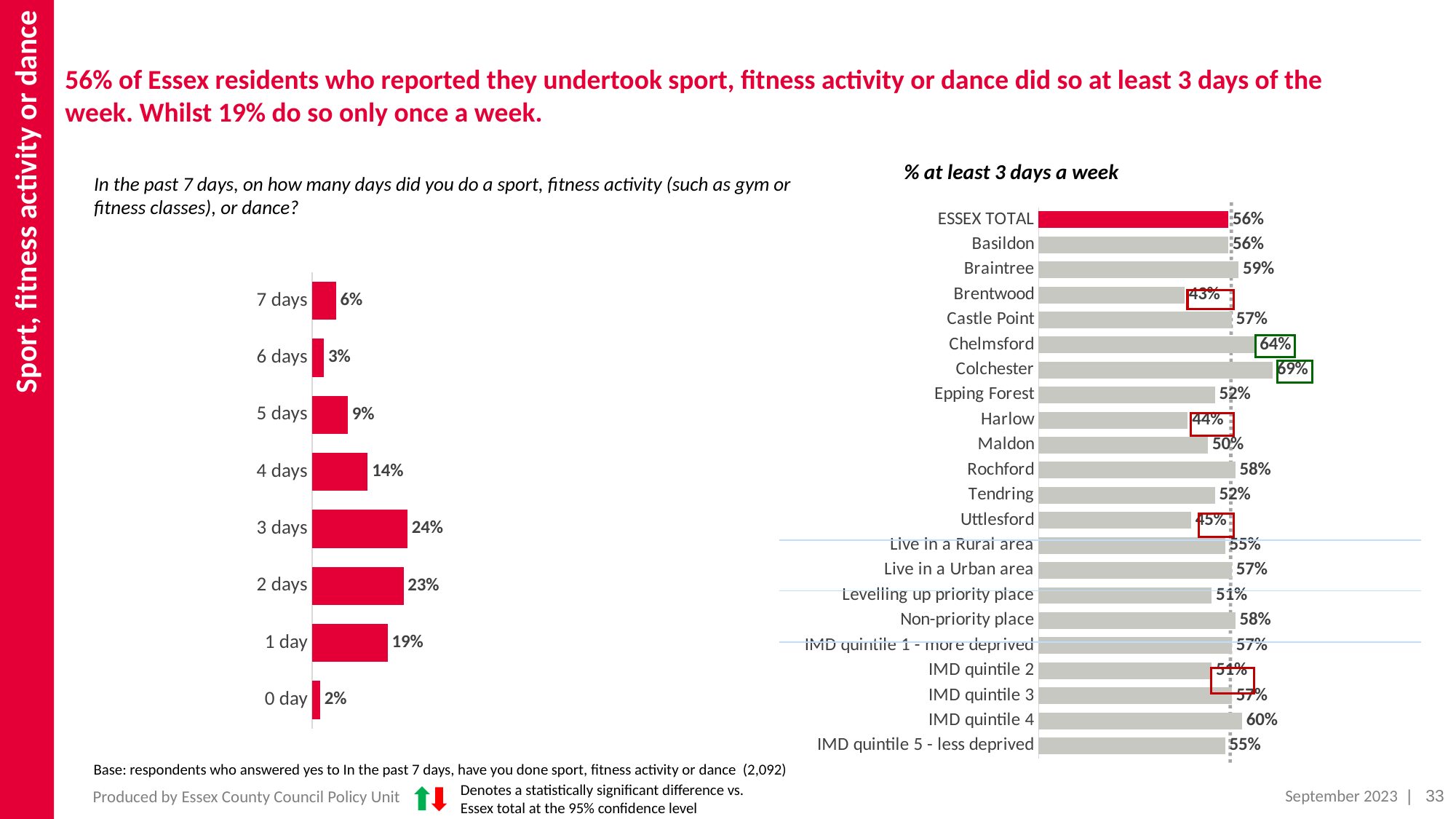
In the left chart on how many days residents did sport, fitness activity or dance, how many categories are shown? 8 In the left chart on how many days residents did sport, fitness activity or dance, which category has the highest value? 3 days In the '% at least 3 days a week' chart, what is the difference between the values for Colchester and ESSEX TOTAL? 13% What type of chart is the '% at least 3 days a week' chart? Bar chart In the left chart on how many days residents did sport, fitness activity or dance, what percentage did so on 7 days? 6% In the '% at least 3 days a week' chart, what is the value for IMD quintile 4? 60% In the '% at least 3 days a week' chart, which is larger, the value for Chelmsford or the value for Harlow? Chelmsford In the '% at least 3 days a week' chart, which category has the lowest value? Brentwood In the left chart on how many days residents did sport, fitness activity or dance, which category has the lowest value? 0 day In the '% at least 3 days a week' chart, what is the value for Colchester? 69% In the left chart on how many days residents did sport, fitness activity or dance, what is the difference between the values for 4 days and 5 days? 5% In the left chart on how many days residents did sport, fitness activity or dance, what percentage did so on 3 days? 24%